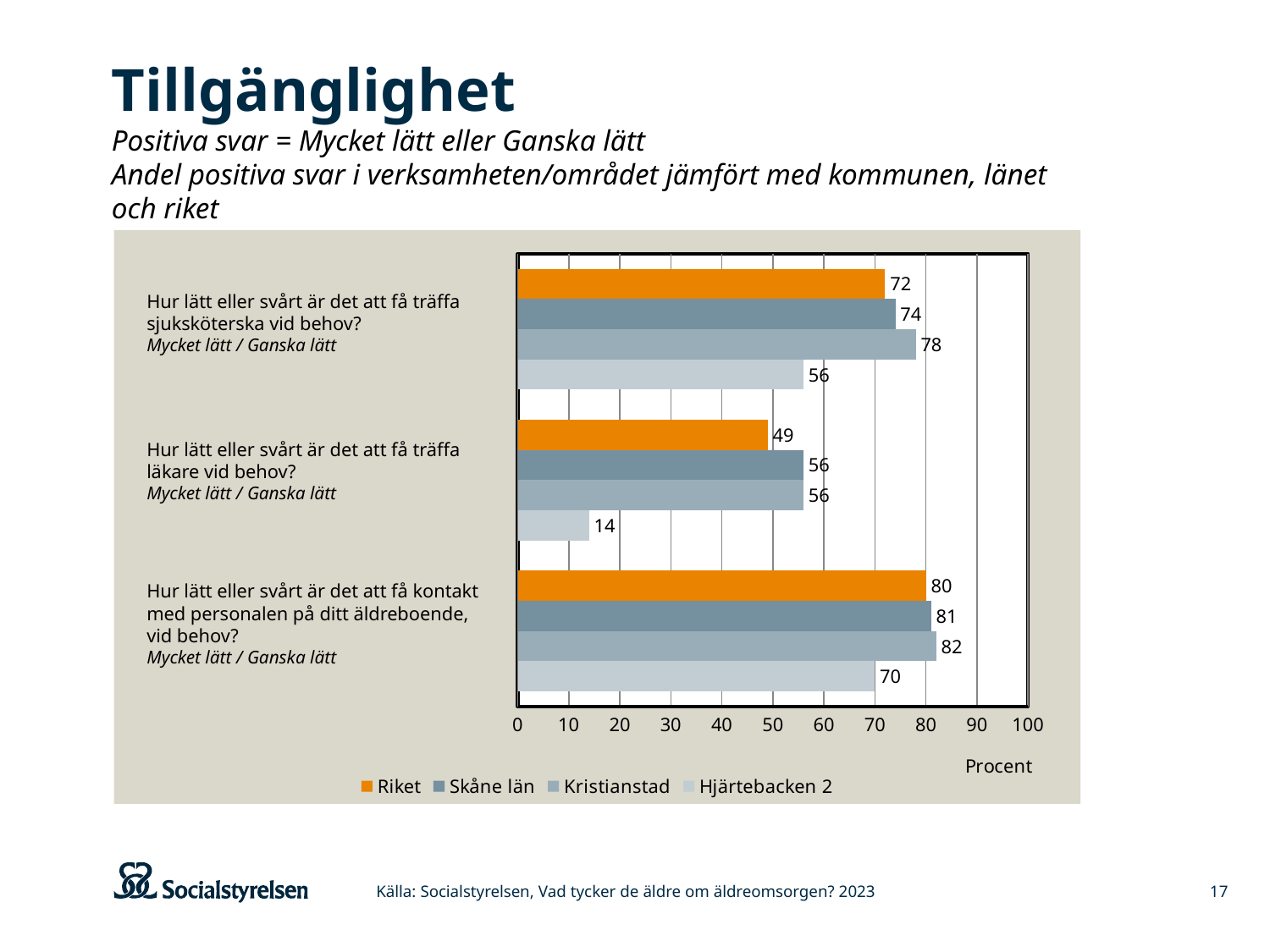
What is the label of the x axis? Procent What is the value for Skåne län on the question about getting to meet a doctor (läkare) when needed? 56 Which is larger: the Hjärtebacken 2 value for contact with staff at the care home, or the Hjärtebacken 2 value for meeting a nurse? Contact with staff at the care home (70) What kind of chart is shown on the slide? Bar chart What is the difference between Kristianstad and Hjärtebacken 2 on the question about getting to meet a nurse when needed? 22 How many series does the legend list? 4 Which series has the highest value on the question about getting in contact with staff at the care home? Kristianstad What is the value for Riket on the question about getting in contact with staff at the care home (kontakt med personalen)? 80 Which series has the lowest value on the question about getting to meet a nurse when needed? Hjärtebacken 2 What is the value for Hjärtebacken 2 on the question about getting to meet a doctor (läkare) when needed? 14 What is the value for Kristianstad on the question about getting to meet a nurse (sjuksköterska) when needed? 78 What is the difference between Riket and Hjärtebacken 2 on the question about getting to meet a doctor when needed? 35